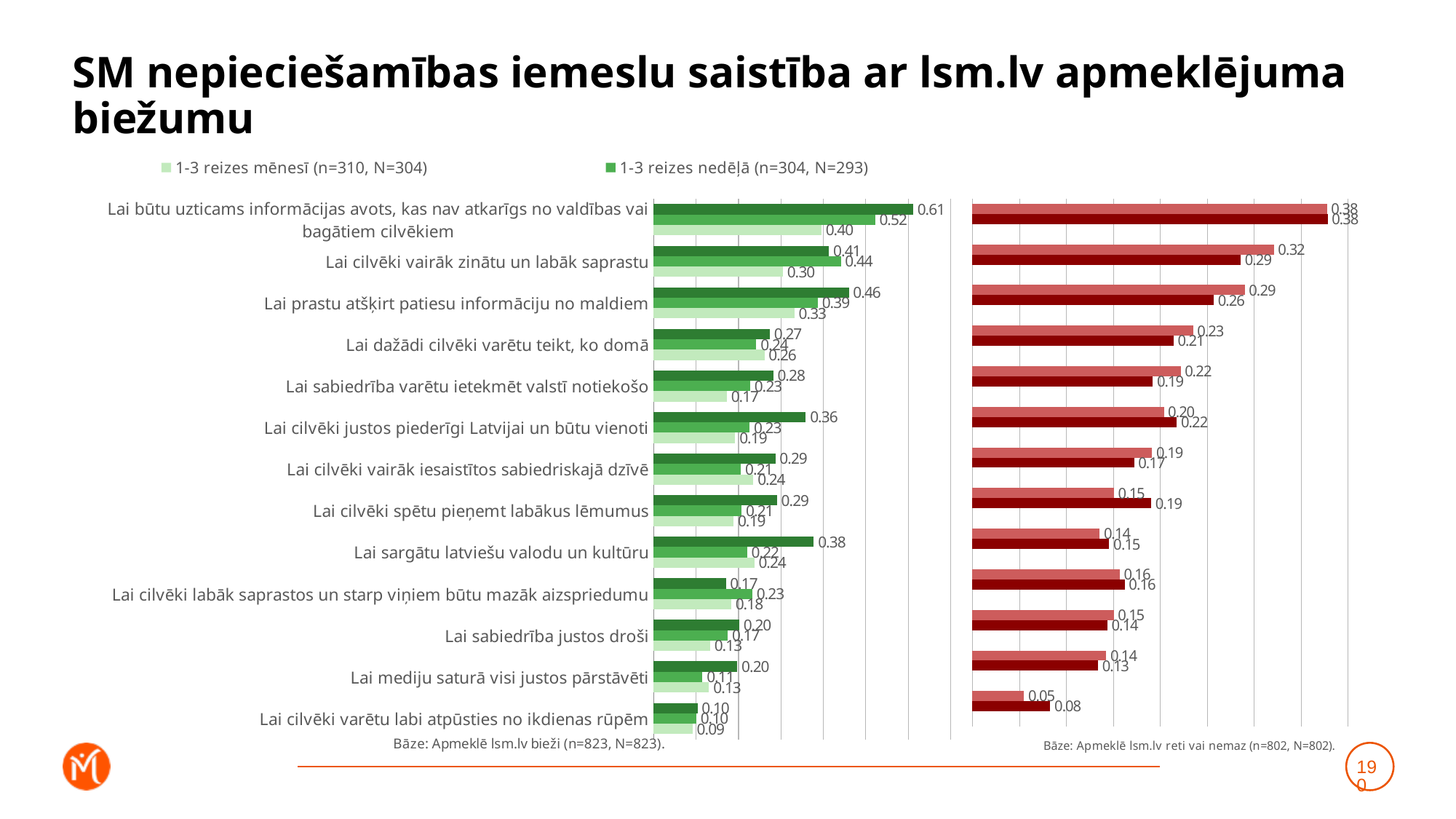
In the right (red) chart, what is the lowest value shown? 0.05 In the left (green) chart, what is the difference between the '1-3 reizes nedēļā' and '1-3 reizes mēnesī' values for 'Lai būtu uzticams informācijas avots, kas nav atkarīgs no valdības vai bagātiem cilvēkiem'? 0.12 In the left (green) chart, which category has the highest value in the '1-3 reizes nedēļā' series? Lai būtu uzticams informācijas avots, kas nav atkarīgs no valdības vai bagātiem cilvēkiem In the left (green) chart, which category has the lowest value in the '1-3 reizes mēnesī' series? Lai cilvēki varētu labi atpūsties no ikdienas rūpēm What kind of chart is shown on the slide? bar chart How many series does the legend at the top of the slide list? 2 In the left (green) chart, what is the value for '1-3 reizes nedēļā' for 'Lai būtu uzticams informācijas avots, kas nav atkarīgs no valdības vai bagātiem cilvēkiem'? 0.52 In the left (green) chart, for 'Lai cilvēki justos piederīgi Latvijai un būtu vienoti', which is larger: the '1-3 reizes nedēļā' value or the '1-3 reizes mēnesī' value? 1-3 reizes nedēļā What base text is printed below the left (green) chart? Bāze: Apmeklē lsm.lv bieži (n=823, N=823). In the left (green) chart, what is the value for '1-3 reizes mēnesī' for 'Lai cilvēki vairāk zinātu un labāk saprastu'? 0.30 How many categories (reasons) are listed on the left chart? 13 In the left (green) chart, what is the value for '1-3 reizes nedēļā' for 'Lai prastu atšķirt patiesu informāciju no maldiem'? 0.39